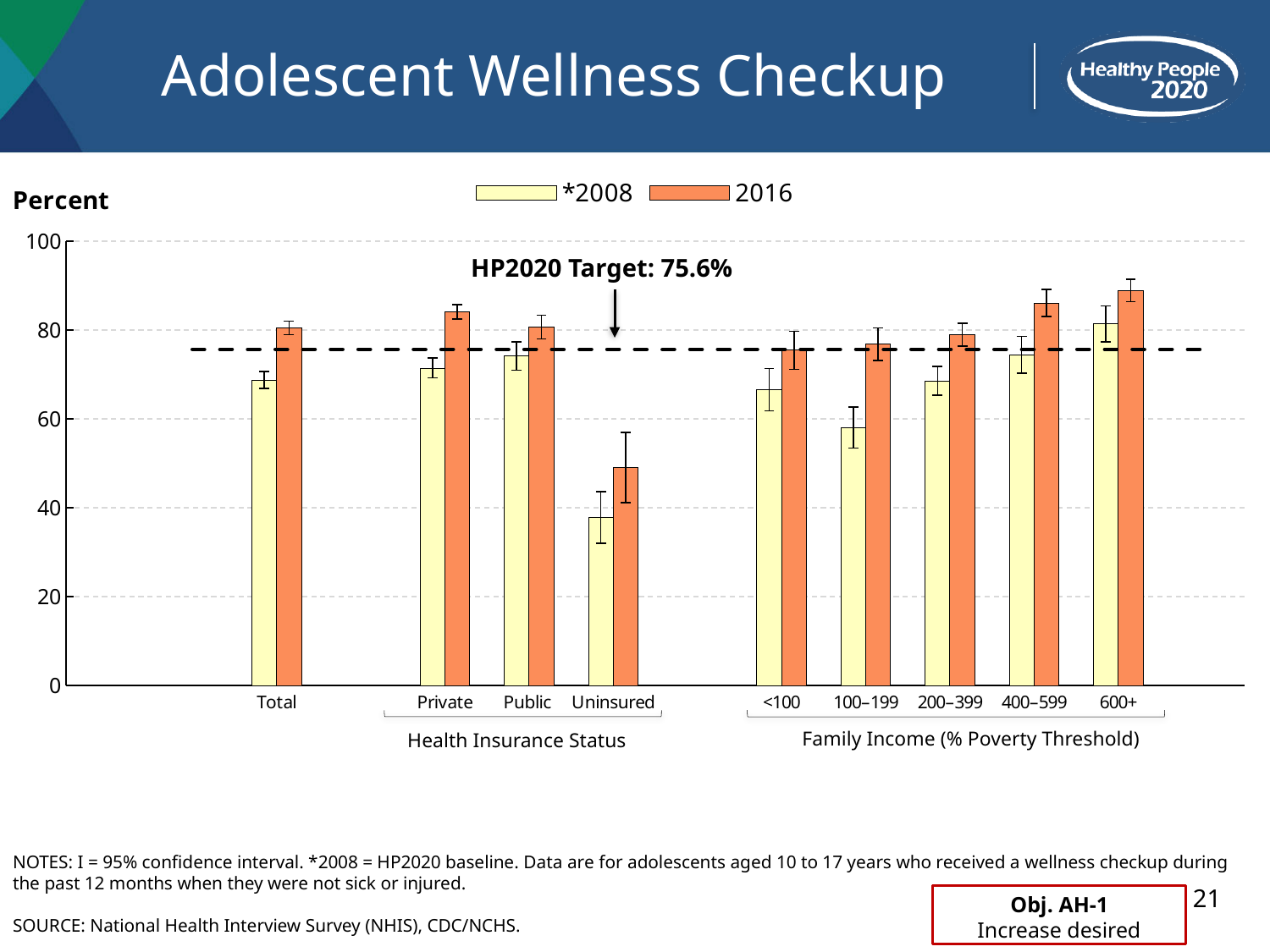
Which has the larger 2016 value, Private or Uninsured? Private Which category has the lowest value for 2016? Uninsured How many categories are shown along the x axis? 9 What kind of chart is shown on the slide? bar chart Which category has the highest value for 2016? 600+ Is the *2008 value for Total greater or less than 60? greater How many series does the legend list? 2 What is the HP2020 Target value shown on the chart? 75.6% Is the 2016 value for Uninsured greater or less than 60? less Which category has the lowest value for *2008? Uninsured Is the 2016 value for 600+ greater or less than 80? greater Across the Family Income categories from <100 to 600+, do the 2016 values rise or fall? rise